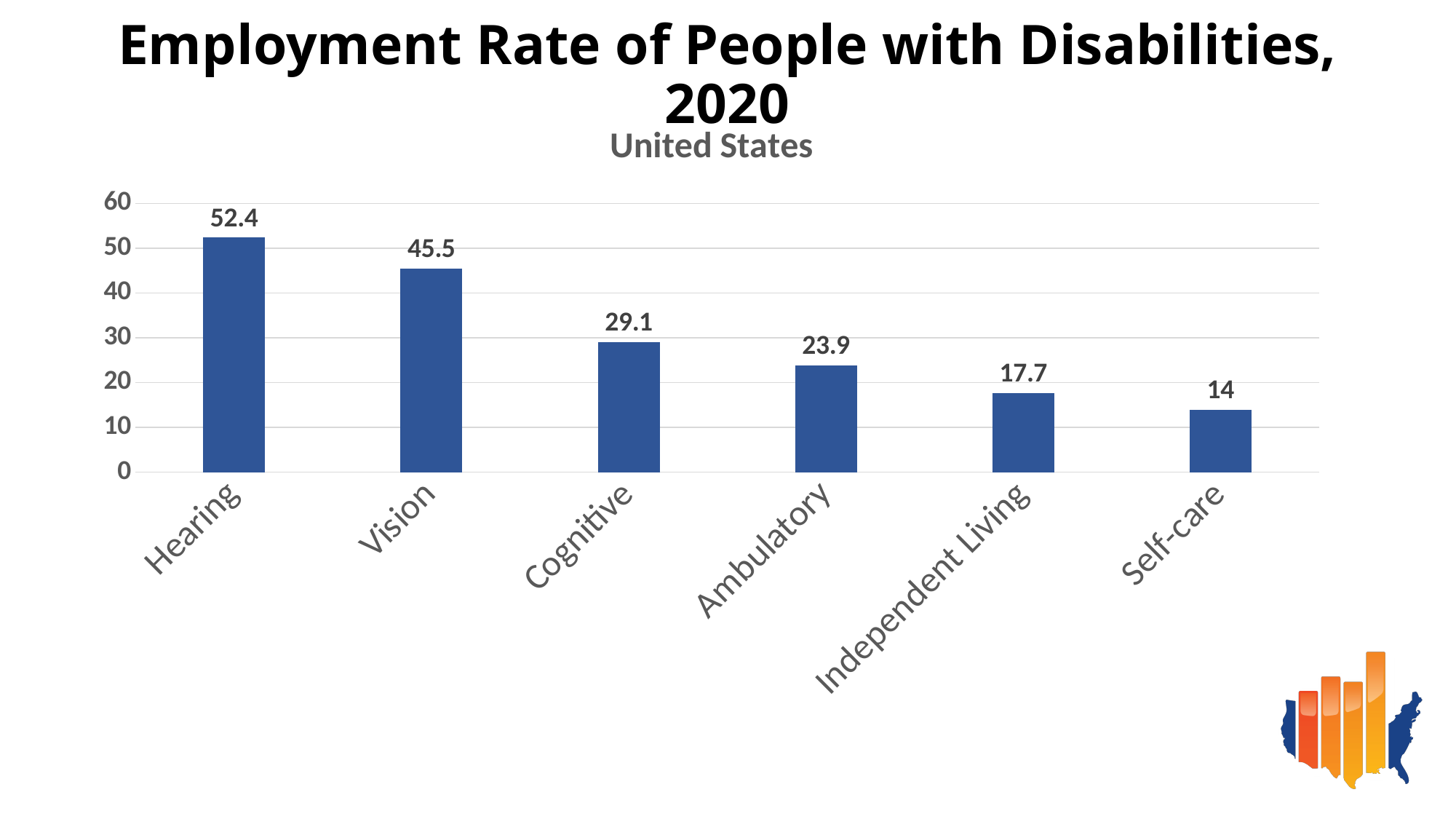
Which disability category has the lowest employment rate? Self-care Which has a higher employment rate, Ambulatory or Independent Living? Ambulatory What kind of chart is shown on the slide? Bar chart How many disability categories are shown on the chart? 6 What is the difference between the employment rates for Cognitive and Ambulatory? 5.2 What is the difference between the employment rates for Hearing and Vision? 6.9 Do the values rise or fall moving from left to right across the categories? Fall What is the employment rate for the Independent Living category? 17.7 Which disability category has the highest employment rate? Hearing What is the employment rate for people with a hearing disability? 52.4 What is the employment rate for the Self-care category? 14 What is the employment rate for people with a cognitive disability? 29.1